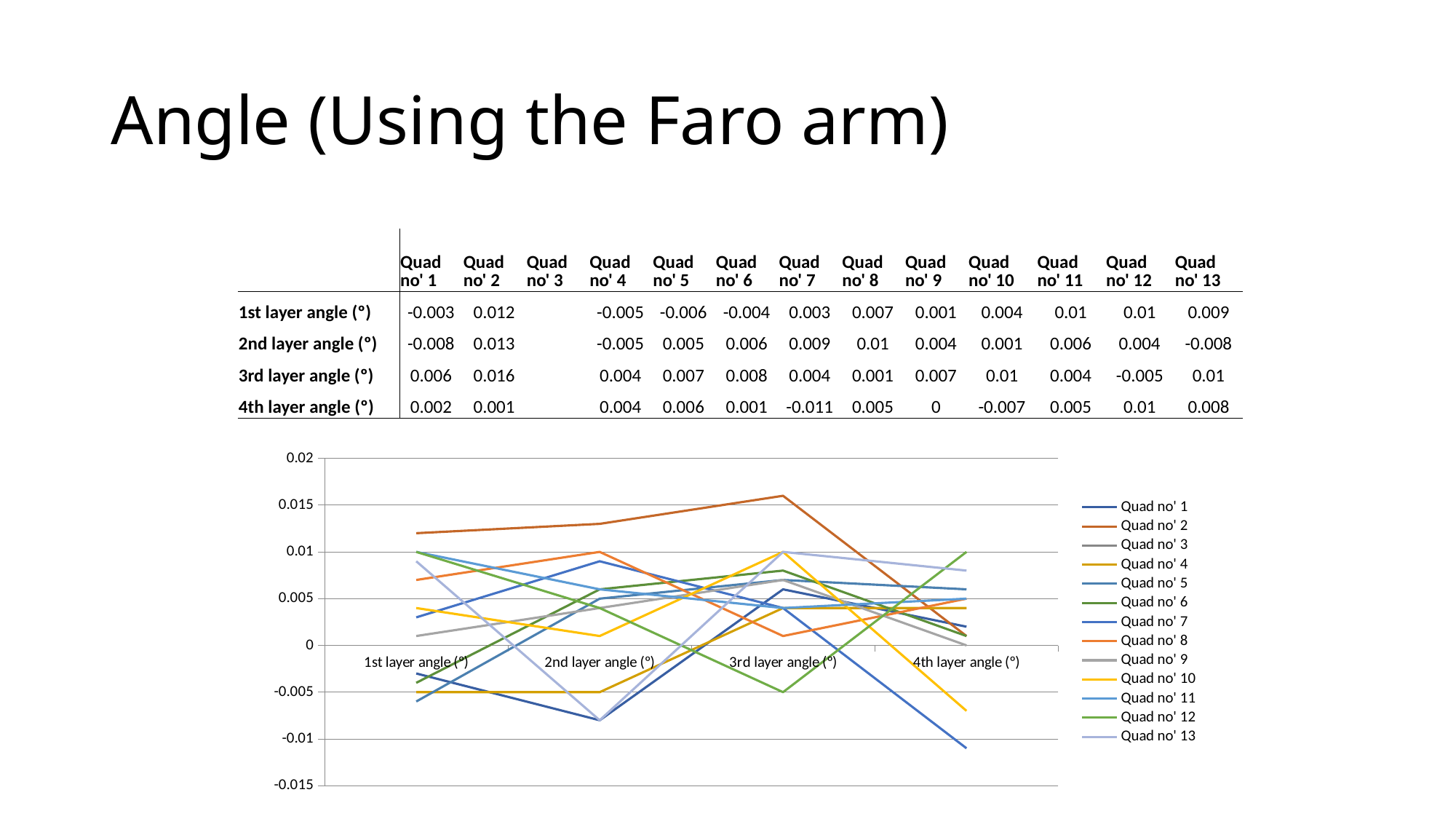
Is the value for Quad no' 7 at 4th layer angle (°) greater or less than -0.005? less What is the value for Quad no' 13 at 1st layer angle (°)? 0.009 What is the value for Quad no' 2 at 3rd layer angle (°)? 0.016 What kind of chart is shown on the slide? line chart What is the value for Quad no' 7 at 4th layer angle (°)? -0.011 How many series does the chart's legend list? 13 What is the difference between the Quad no' 2 values at 3rd layer angle (°) and 1st layer angle (°)? 0.004 Which series has the highest value at 3rd layer angle (°)? Quad no' 2 Which series has the lowest value at 4th layer angle (°)? Quad no' 7 How many categories are plotted along the x axis of the chart? 4 Does the Quad no' 2 line rise or fall from 1st layer angle (°) to 3rd layer angle (°)? rise At 1st layer angle (°), which is larger: Quad no' 2 or Quad no' 1? Quad no' 2